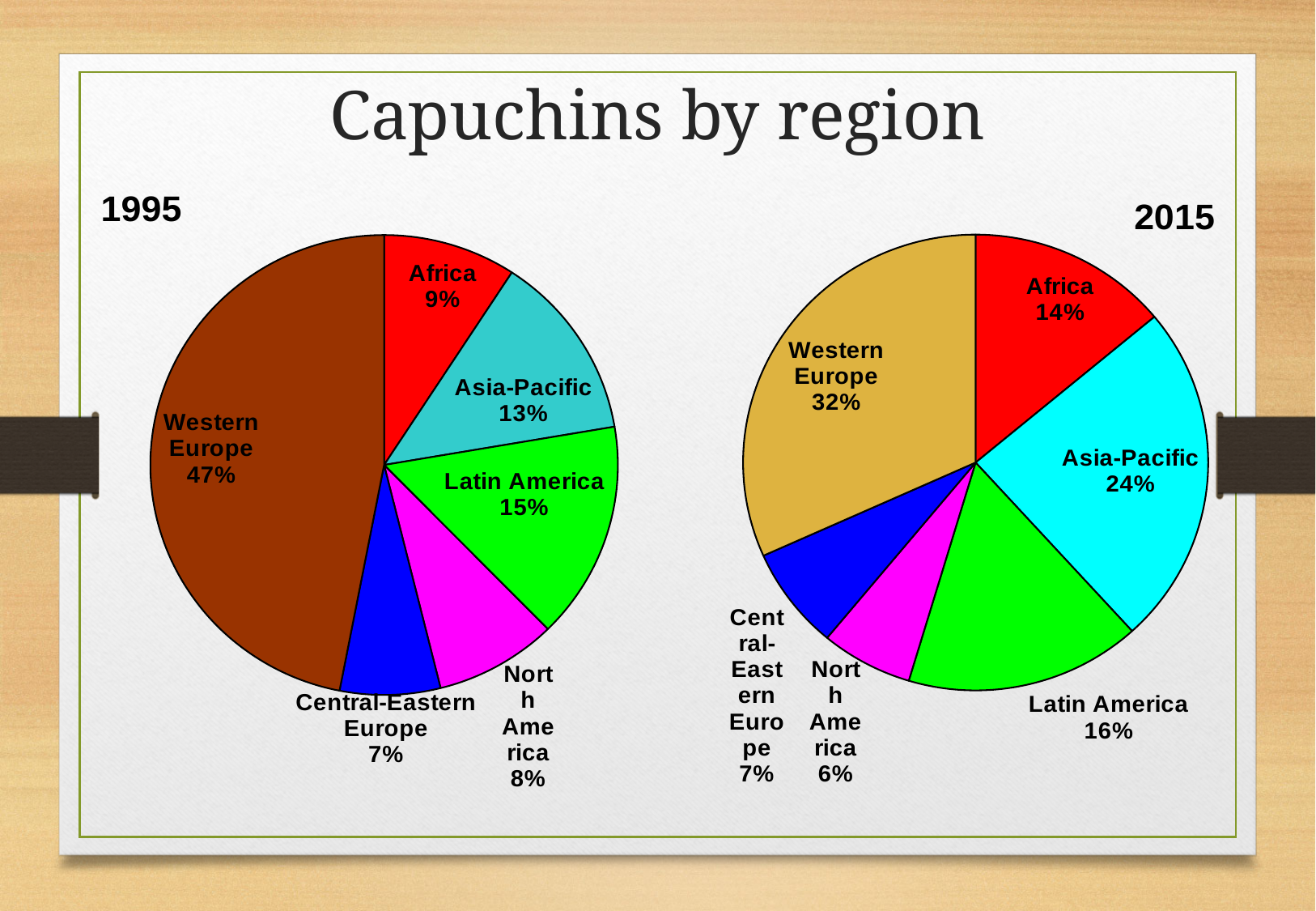
In the 1995 pie chart, what share does Western Europe have? 47% What type of chart is used on this slide? Pie chart How many regions are shown in the 2015 pie chart? 6 In the 1995 pie chart, which region has the largest share? Western Europe In the 1995 pie chart, what is the difference between Latin America's share and Africa's share? 6 percentage points In the 2015 pie chart, which is larger: Latin America or Asia-Pacific? Asia-Pacific In the 2015 pie chart, which region has the smallest share? North America What is the difference between Western Europe's share in 1995 and in 2015? 15 percentage points In the 1995 pie chart, which region has the smallest share? Central-Eastern Europe In the 2015 pie chart, what share does Africa have? 14% In the 2015 pie chart, what share does Asia-Pacific have? 24% What is the title of the slide? Capuchins by region